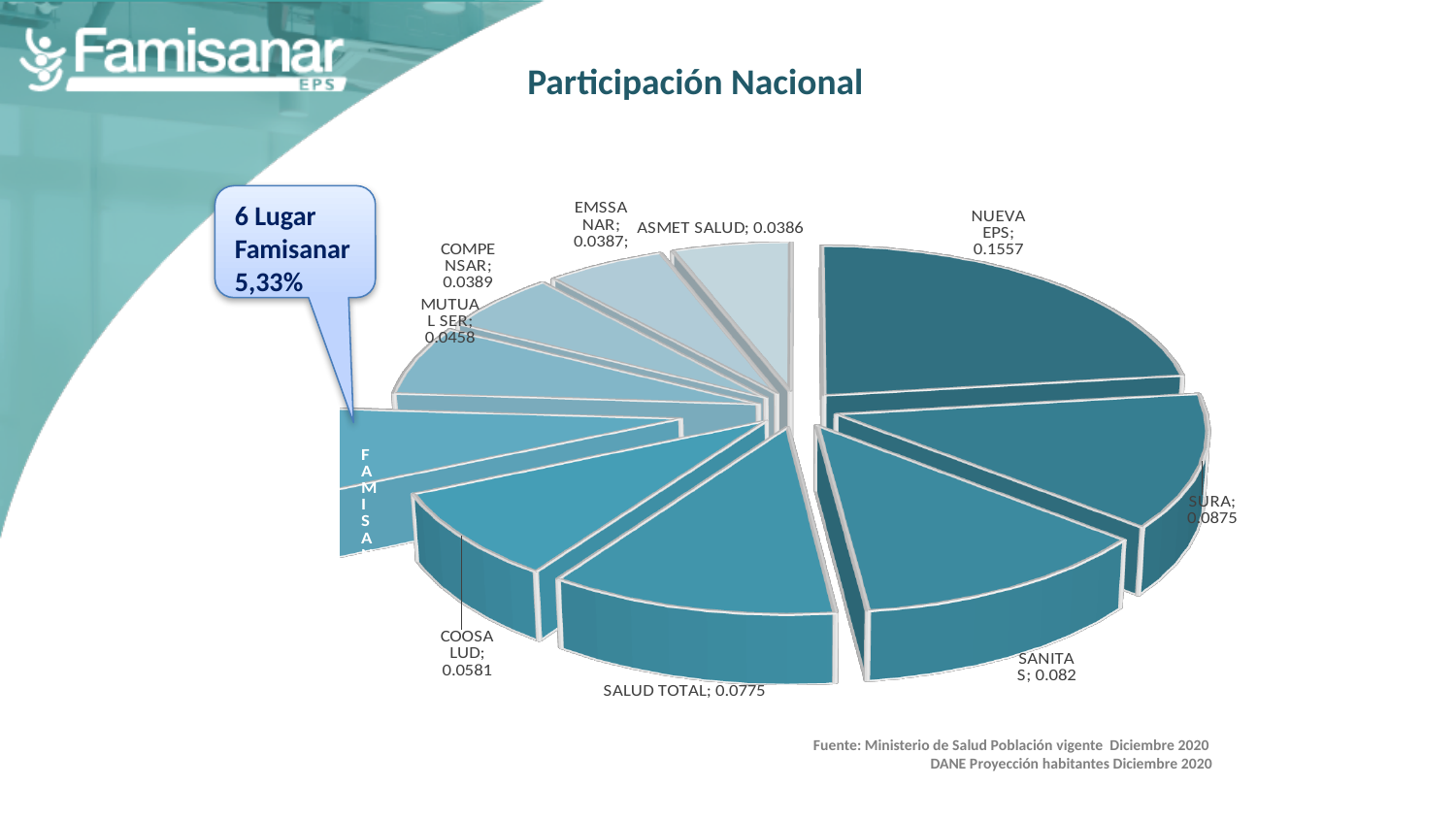
What is the difference between the values for NUEVA EPS and SURA? 0.0682 What is the value shown for ASMET SALUD? 0.0386 What is the value shown for COOSALUD? 0.0581 Which category has the largest slice of the pie? NUEVA EPS According to the callout, what share does Famisanar have? 5,33% What kind of chart is shown on the slide? pie chart What is the value shown for NUEVA EPS? 0.1557 What is the value shown for SURA? 0.0875 What is the value shown for MUTUAL SER? 0.0458 What is the value shown for SALUD TOTAL? 0.0775 What is the value shown for SANITAS? 0.082 Which is larger, the value for SURA or the value for SANITAS? SURA